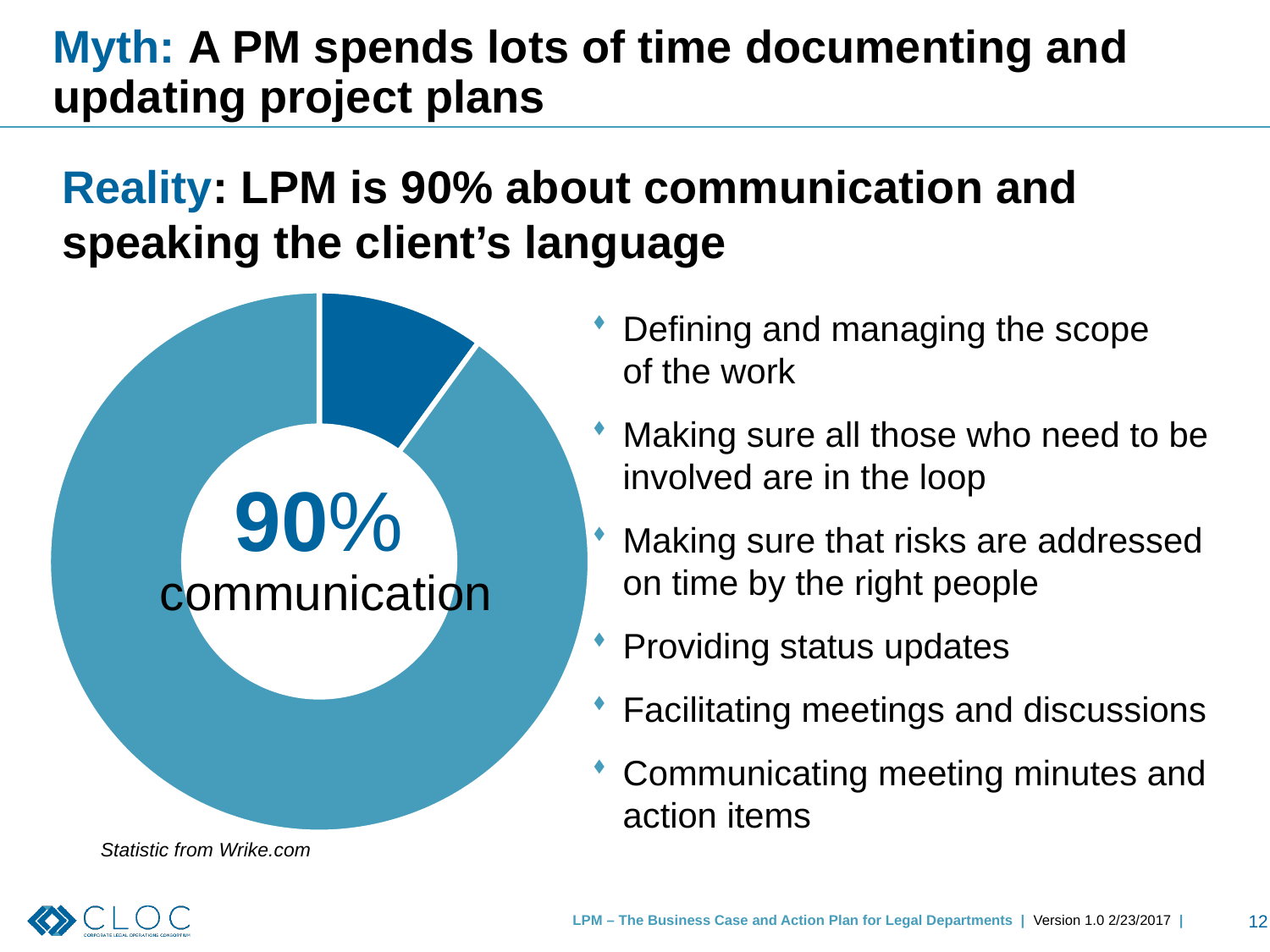
What percentage does the chart show for communication? 90% Which is larger: the communication slice or the dark blue slice? communication Is the value for communication greater or less than 50%? greater According to the note under the chart, where is the statistic from? Wrike.com What share of the chart does the dark blue slice represent? 10% What kind of chart is shown on the left of the slide? pie chart (donut) Which slice of the chart is the smallest? the dark blue slice Which slice of the chart is the largest? communication What colour is the communication slice of the chart? light blue How many slices does the donut chart have? 2